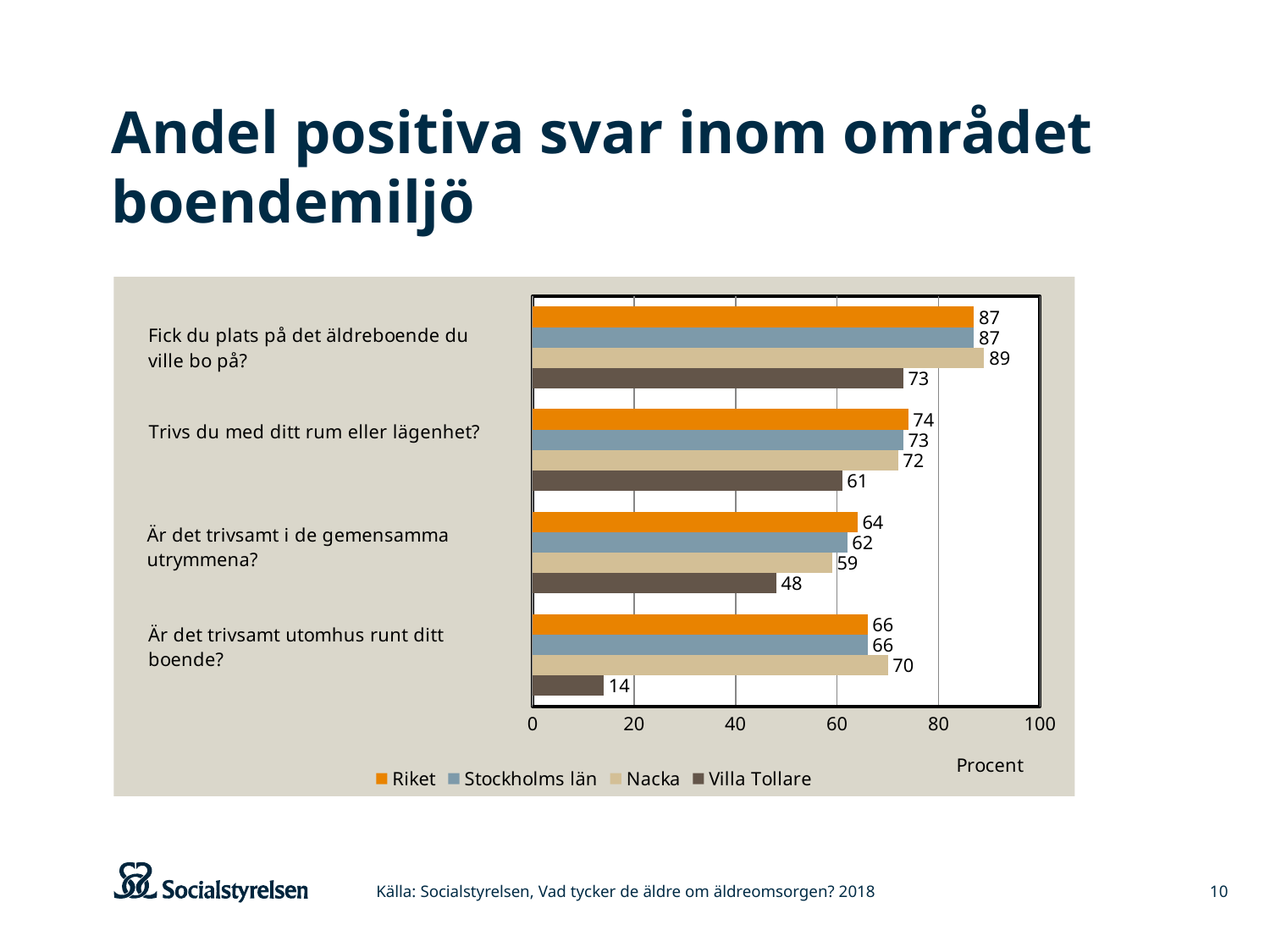
What is the value for Villa Tollare on "Är det trivsamt utomhus runt ditt boende?"? 14 Which series has the lowest value on "Är det trivsamt i de gemensamma utrymmena?"? Villa Tollare Which is larger on "Är det trivsamt utomhus runt ditt boende?": Nacka or Riket? Nacka What is the value for Stockholms län on "Trivs du med ditt rum eller lägenhet?"? 73 How many questions (categories) are shown on the chart? 4 What is the value for Nacka on "Fick du plats på det äldreboende du ville bo på?"? 89 What kind of chart is shown on the slide? bar chart How many series does the legend list? 4 Which series has the highest value on "Fick du plats på det äldreboende du ville bo på?"? Nacka What is the difference between Riket and Villa Tollare on "Trivs du med ditt rum eller lägenhet?"? 13 What is the unit label shown on the x axis? Procent Is the value for Villa Tollare on "Fick du plats på det äldreboende du ville bo på?" greater or less than 80? less